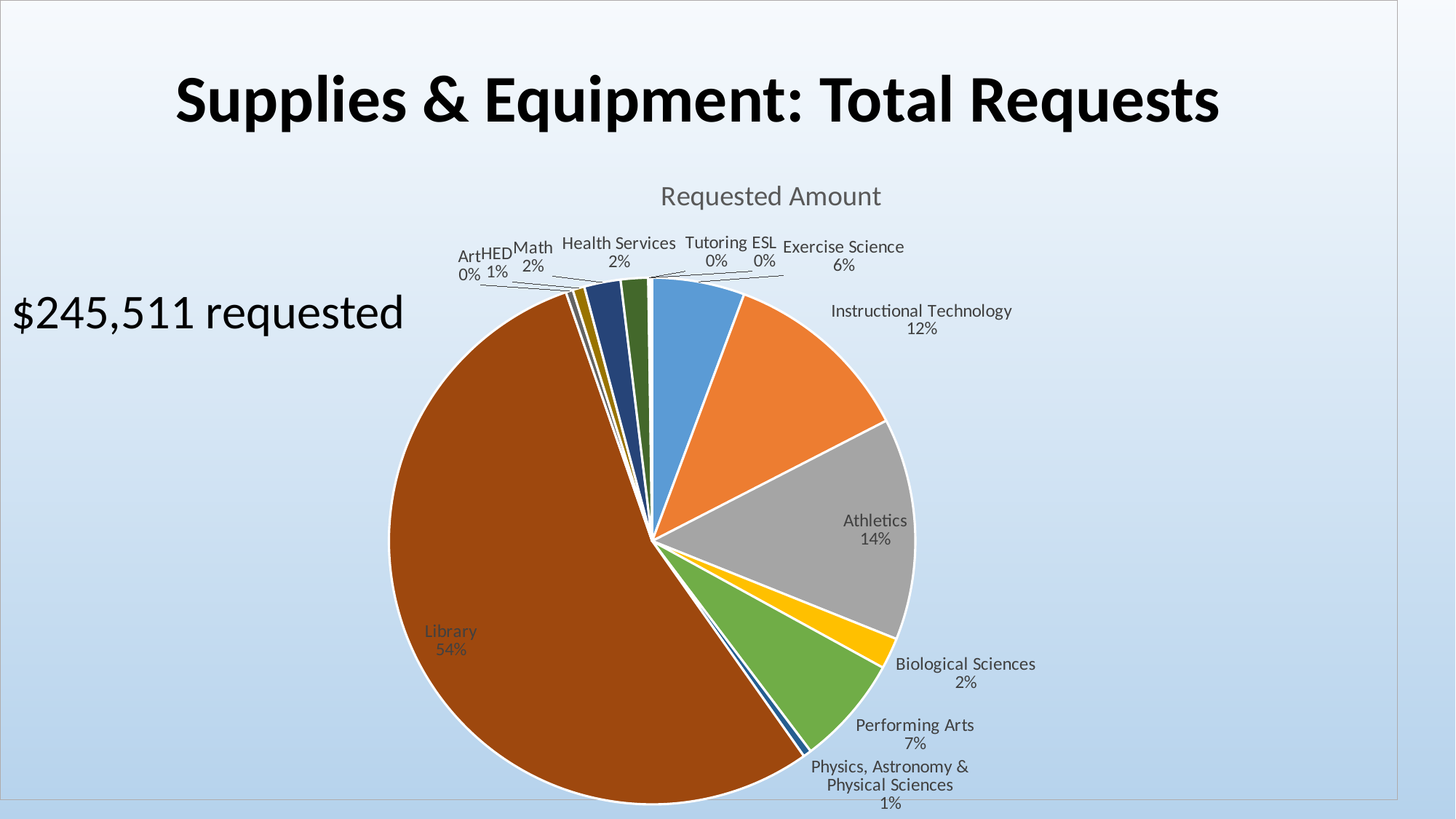
What is the difference in percentage points between the Library share and the Athletics share? 40 How many categories are shown in the pie chart? 13 What type of chart is shown on the slide? pie chart Which category has the largest slice of the pie? Library What share of the pie does Performing Arts account for? 7% What total requested amount is stated on the slide next to the chart? $245,511 What share of the pie does Athletics account for? 14% What is the title of the chart? Requested Amount What share of the pie does Library account for? 54% Which is larger, the share for Athletics or the share for Instructional Technology? Athletics